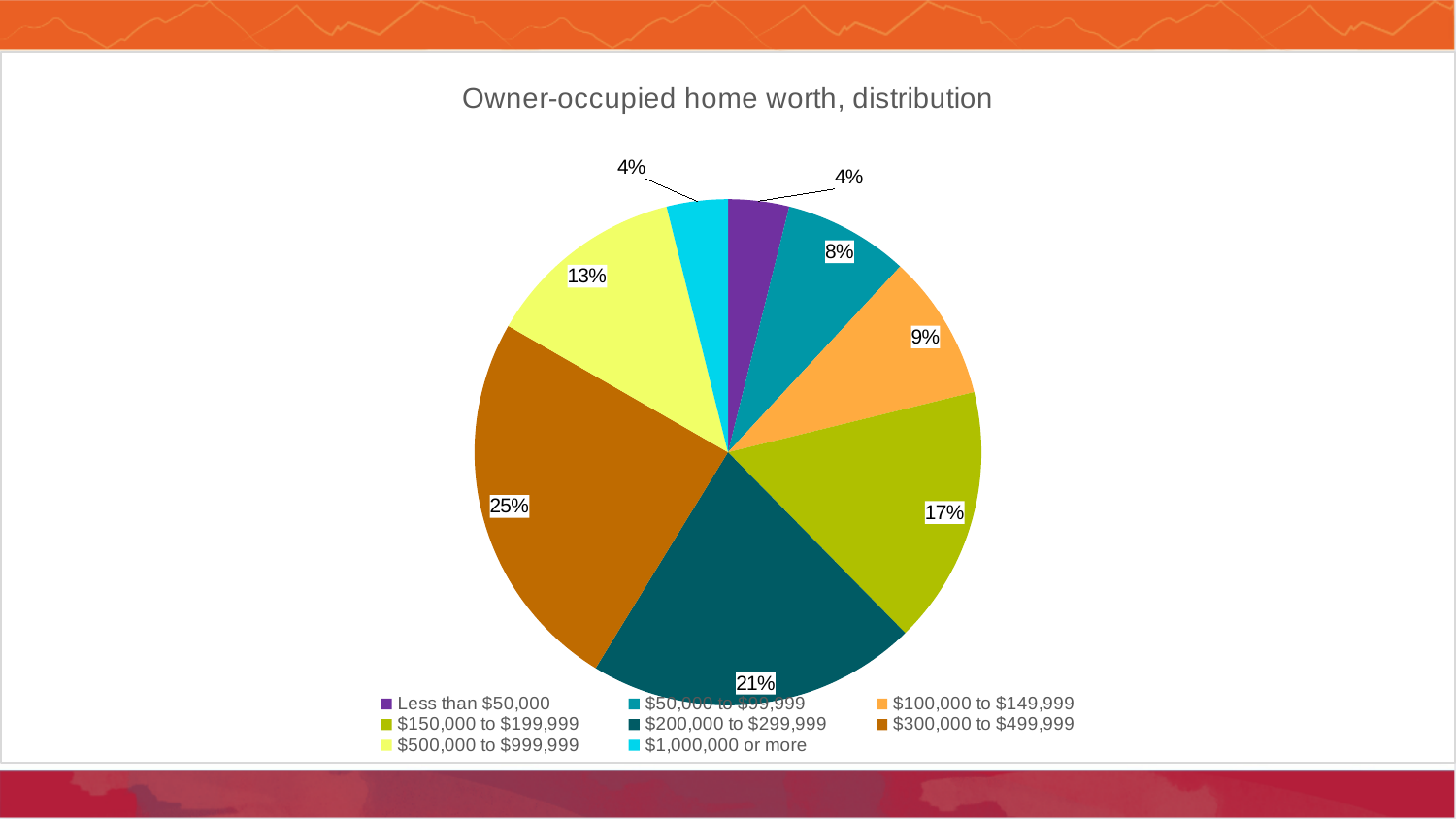
What share of the pie is the $200,000 to $299,999 slice? 21% What is the difference in percentage points between the $300,000 to $499,999 slice and the $200,000 to $299,999 slice? 4 How many categories does the legend list? 8 What share of the pie is the $300,000 to $499,999 slice? 25% Which slice is larger: $100,000 to $149,999 or $150,000 to $199,999? $150,000 to $199,999 What share of the pie is the $1,000,000 or more slice? 4% What is the title of the chart? Owner-occupied home worth, distribution What kind of chart is shown on the slide? pie chart Which category has the largest slice of the pie? $300,000 to $499,999